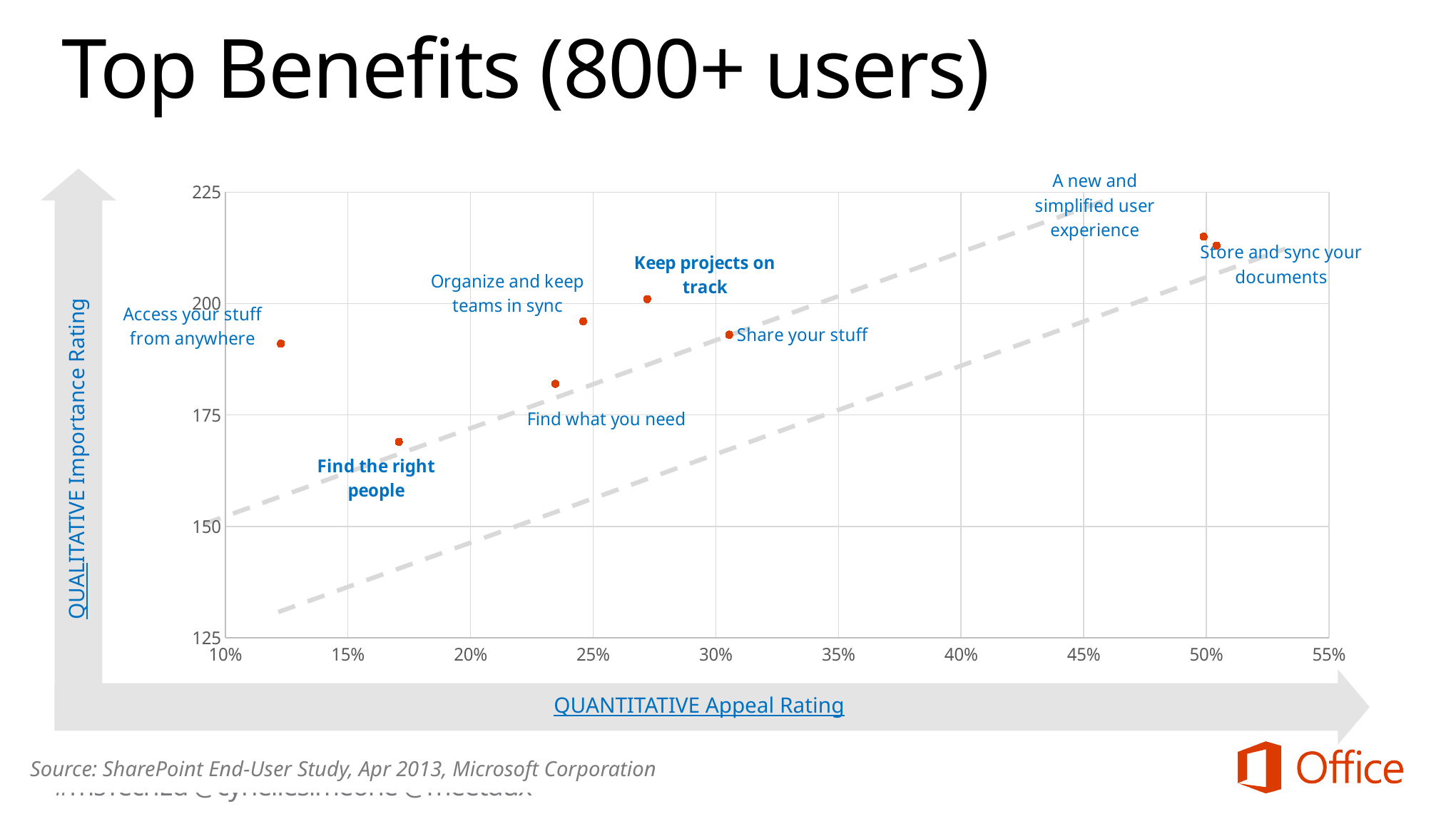
Which benefit has the lowest qualitative importance rating? Find the right people Is the quantitative appeal rating for Access your stuff from anywhere greater or less than 15%? less Is the qualitative importance rating for Access your stuff from anywhere greater or less than 200? less Is the qualitative importance rating for Find the right people greater or less than 175? less Which has a higher quantitative appeal rating, Share your stuff or Keep projects on track? Share your stuff Which benefit has the lowest quantitative appeal rating? Access your stuff from anywhere What is the label of the horizontal axis? QUANTITATIVE Appeal Rating What kind of chart is shown on the slide? scatter chart How many data points are plotted on the chart? 8 Which has a higher qualitative importance rating, Find what you need or Find the right people? Find what you need